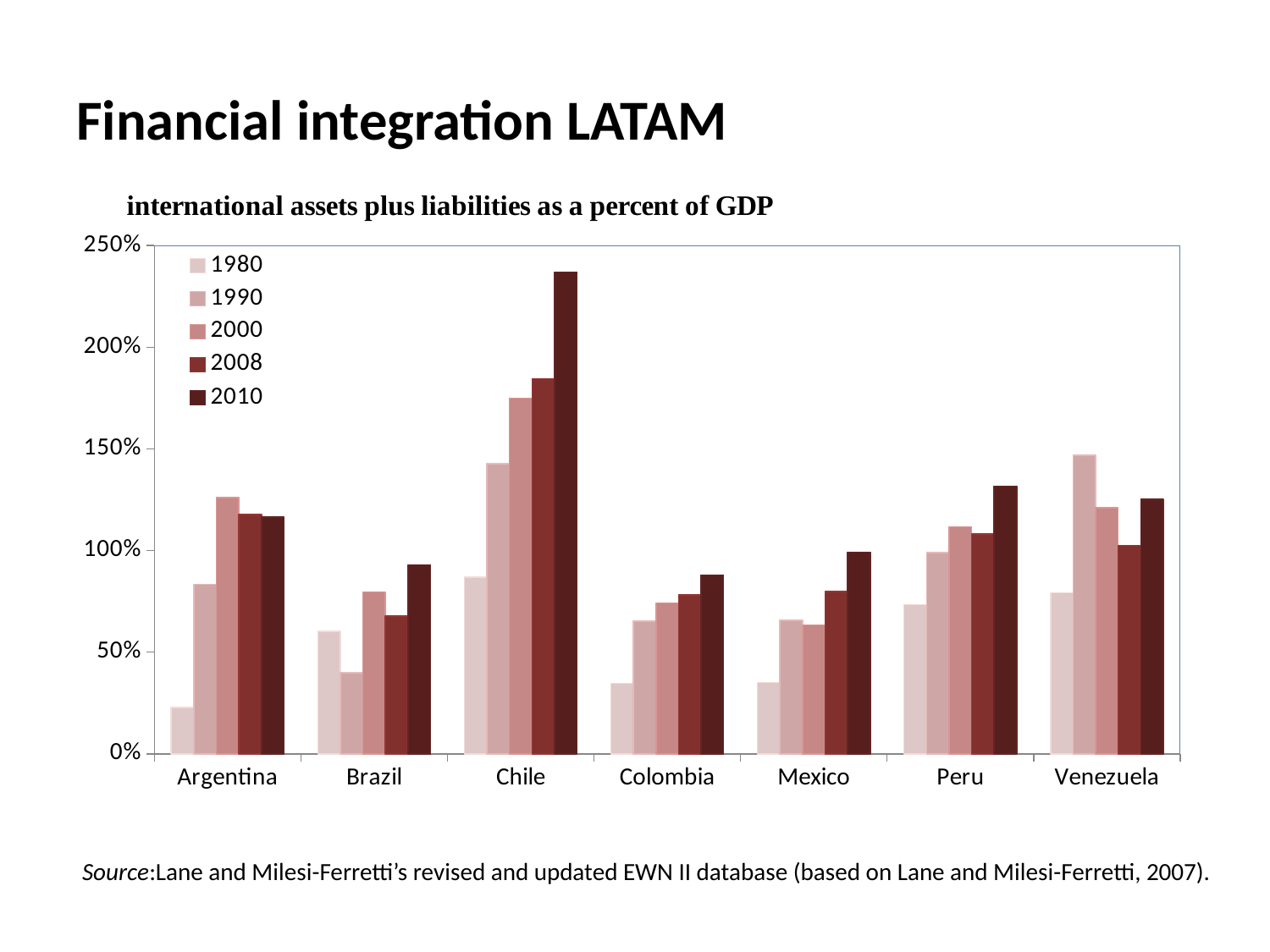
Which is larger: the 2010 value for Peru or the 2010 value for Mexico? Peru For Venezuela, which is larger: the 1990 value or the 2010 value? 1990 What is the title of the chart? international assets plus liabilities as a percent of GDP How many countries are shown on the x axis? 7 Is the 2010 value for Peru greater or less than 100%? greater Which country has the highest value for 2010? Chile Is the 2010 value for Chile greater or less than 200%? greater Which country has the lowest value for 1980? Argentina For Colombia, do the values rise or fall from 1980 to 2010? rise How many series does the legend list? 5 What kind of chart is shown on the slide? bar chart Is the 1980 value for Argentina greater or less than 50%? less